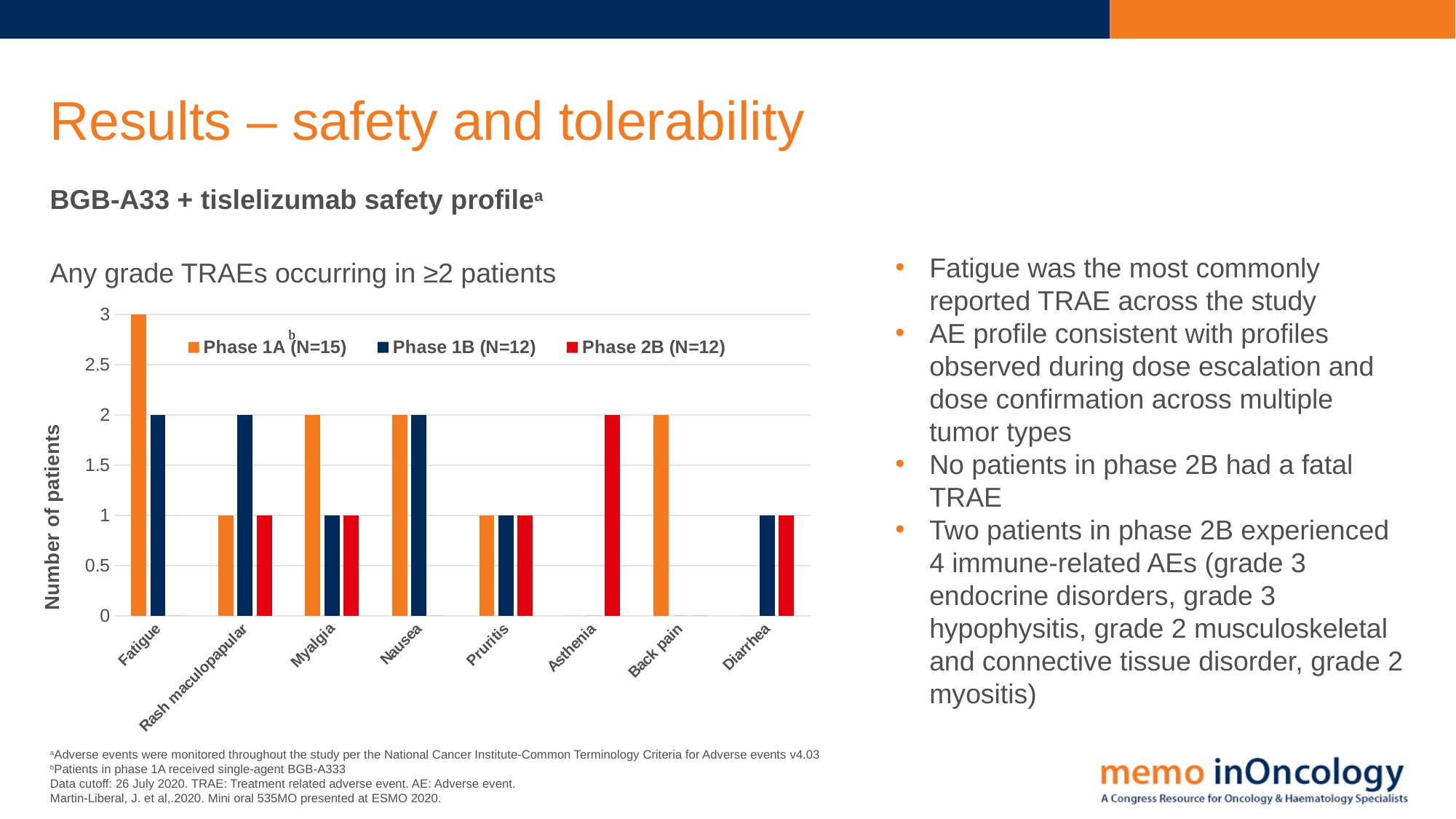
What is the number of patients with Rash maculopapular in Phase 1B (N=12)? 2 What is the number of patients with Asthenia in Phase 2B (N=12)? 2 What is the difference between the Phase 1A (N=15) and Phase 1B (N=12) values for Fatigue? 1 Which adverse event has the highest number of patients in Phase 1A (N=15)? Fatigue Is the Phase 1A (N=15) value for Fatigue greater or less than 2.5? greater How many adverse event categories are shown on the x axis of the chart? 8 For Myalgia, which is larger: the Phase 1A (N=15) value or the Phase 1B (N=12) value? Phase 1A (N=15) What is the number of patients with Fatigue in Phase 1A (N=15)? 3 What is the label of the y axis of the chart? Number of patients How many series does the chart legend list? 3 What is the title of the chart? Any grade TRAEs occurring in ≥2 patients What type of chart is shown on the slide? bar chart